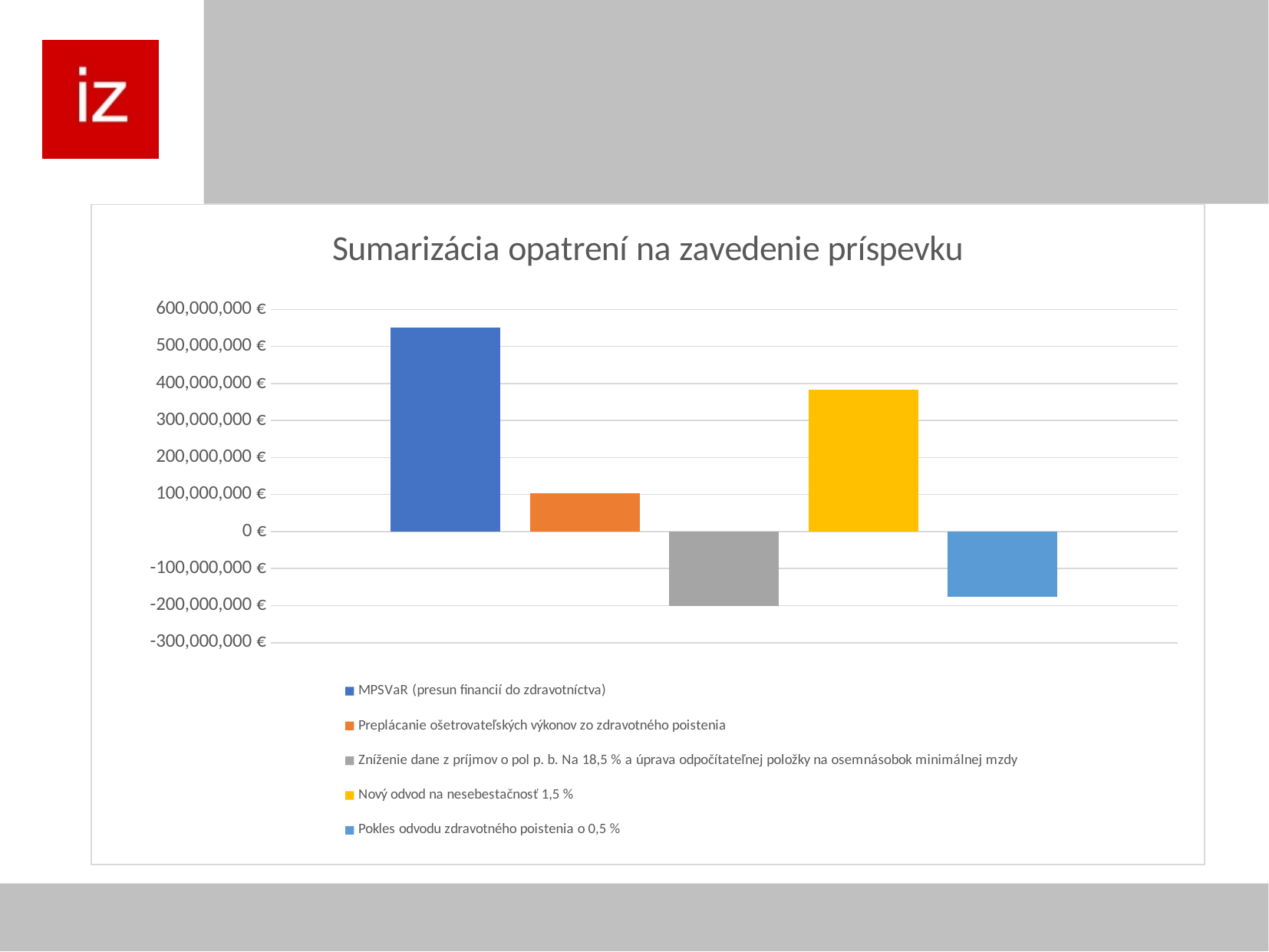
Is the value for Zníženie dane z príjmov o pol p. b. greater or less than -100,000,000 €? less How many bars are plotted in the chart? 5 What kind of chart is shown on the slide? Bar chart Is the value for MPSVaR (presun financií do zdravotníctva) greater or less than 500,000,000 €? greater Is the value for Nový odvod na nesebestačnosť 1,5 % greater or less than 300,000,000 €? greater Which is larger: the value for MPSVaR (presun financií do zdravotníctva) or the value for Nový odvod na nesebestačnosť 1,5 %? MPSVaR (presun financií do zdravotníctva) What is the title of the chart? Sumarizácia opatrení na zavedenie príspevku Which series has the highest value? MPSVaR (presun financií do zdravotníctva) Which series has the lowest value? Zníženie dane z príjmov o pol p. b. Na 18,5 % a úprava odpočítateľnej položky na osemnásobok minimálnej mzdy How many series does the legend list? 5 How many bars in the chart have negative values? 2